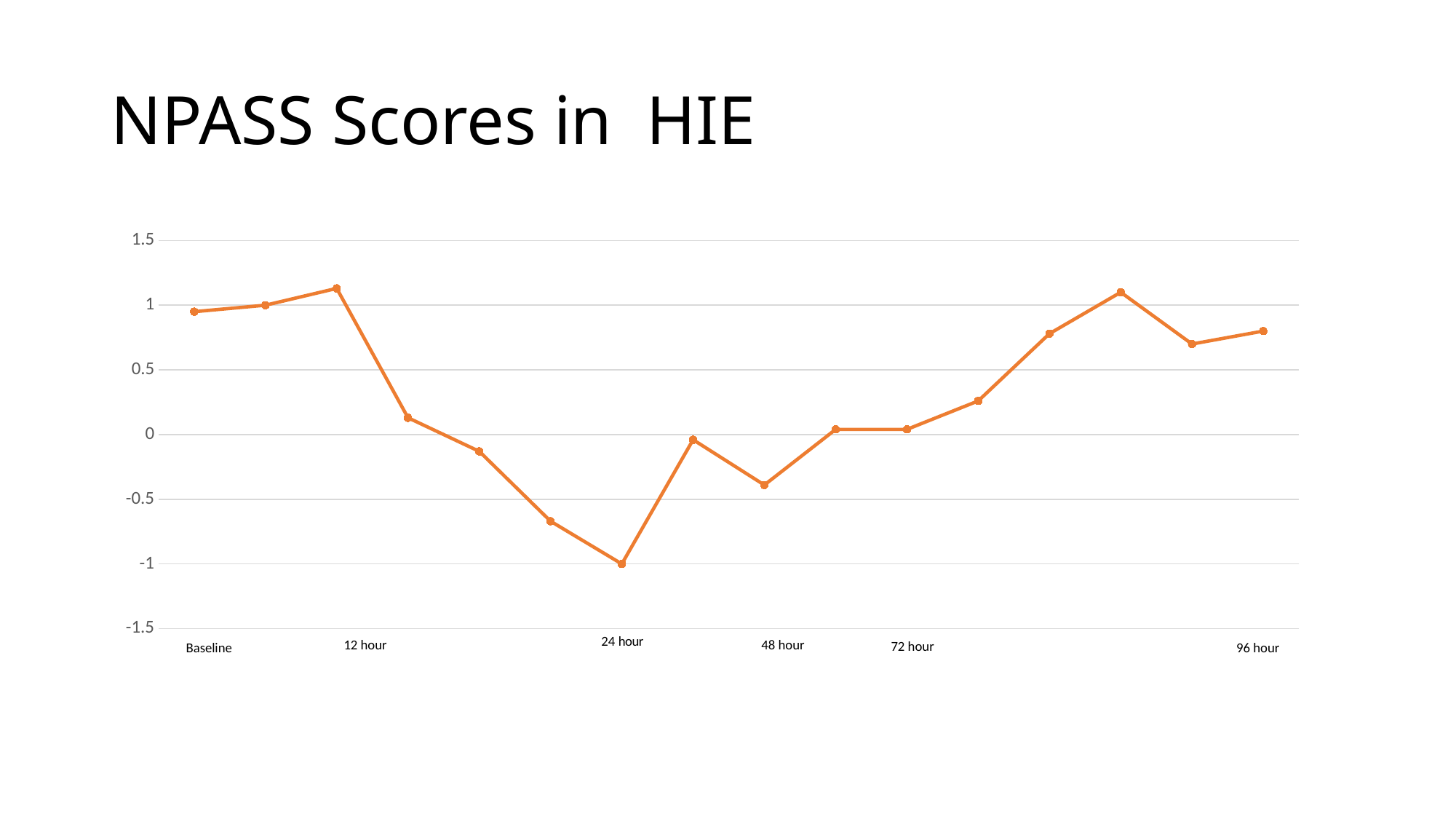
Is the value at 48 hour greater or less than 0? less Is the value at 12 hour greater or less than 1? greater What kind of chart is shown on the slide? line chart Which labelled time point has the lowest NPASS score? 24 hour Is the value at 96 hour greater or less than 0.5? greater What is the NPASS score at 24 hour? -1 Which is larger, the value at 12 hour or the value at 96 hour? 12 hour Which is larger, the value at Baseline or the value at 48 hour? Baseline Do the values rise or fall between 12 hour and 24 hour? fall How many data points are plotted on the line? 16 What is the title of the chart? NPASS Scores in HIE